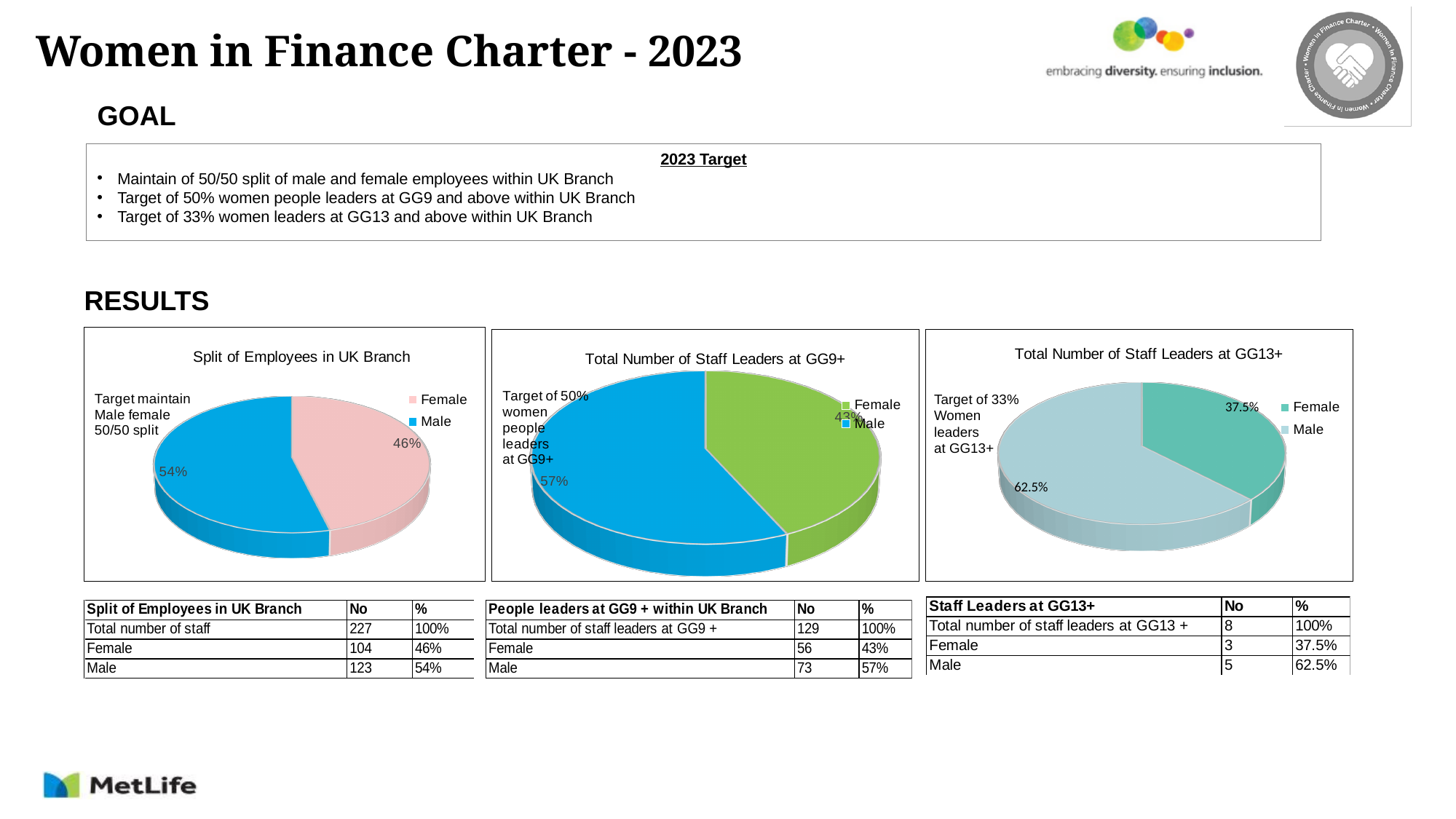
In the 'Split of Employees in UK Branch' chart, what percentage is shown for Female? 46% In the 'Total Number of Staff Leaders at GG13+' chart, what is the difference in percentage points between Male and Female? 25 In the 'Total Number of Staff Leaders at GG13+' chart, what percentage is shown for Female? 37.5% In the 'Total Number of Staff Leaders at GG9+' chart, which is larger, the Female slice or the Male slice? Male How many categories does the legend of the 'Total Number of Staff Leaders at GG9+' chart list? 2 In the 'Total Number of Staff Leaders at GG9+' chart, what percentage is shown for Female? 43% In the 'Split of Employees in UK Branch' chart, which category has the smallest slice? Female How many pie charts are shown on the slide? 3 What type of chart is 'Split of Employees in UK Branch'? Pie chart In the 'Total Number of Staff Leaders at GG13+' chart, which category has the largest slice? Male In the 'Total Number of Staff Leaders at GG9+' chart, what percentage is shown for Male? 57% In the 'Split of Employees in UK Branch' chart, what percentage is shown for Male? 54%